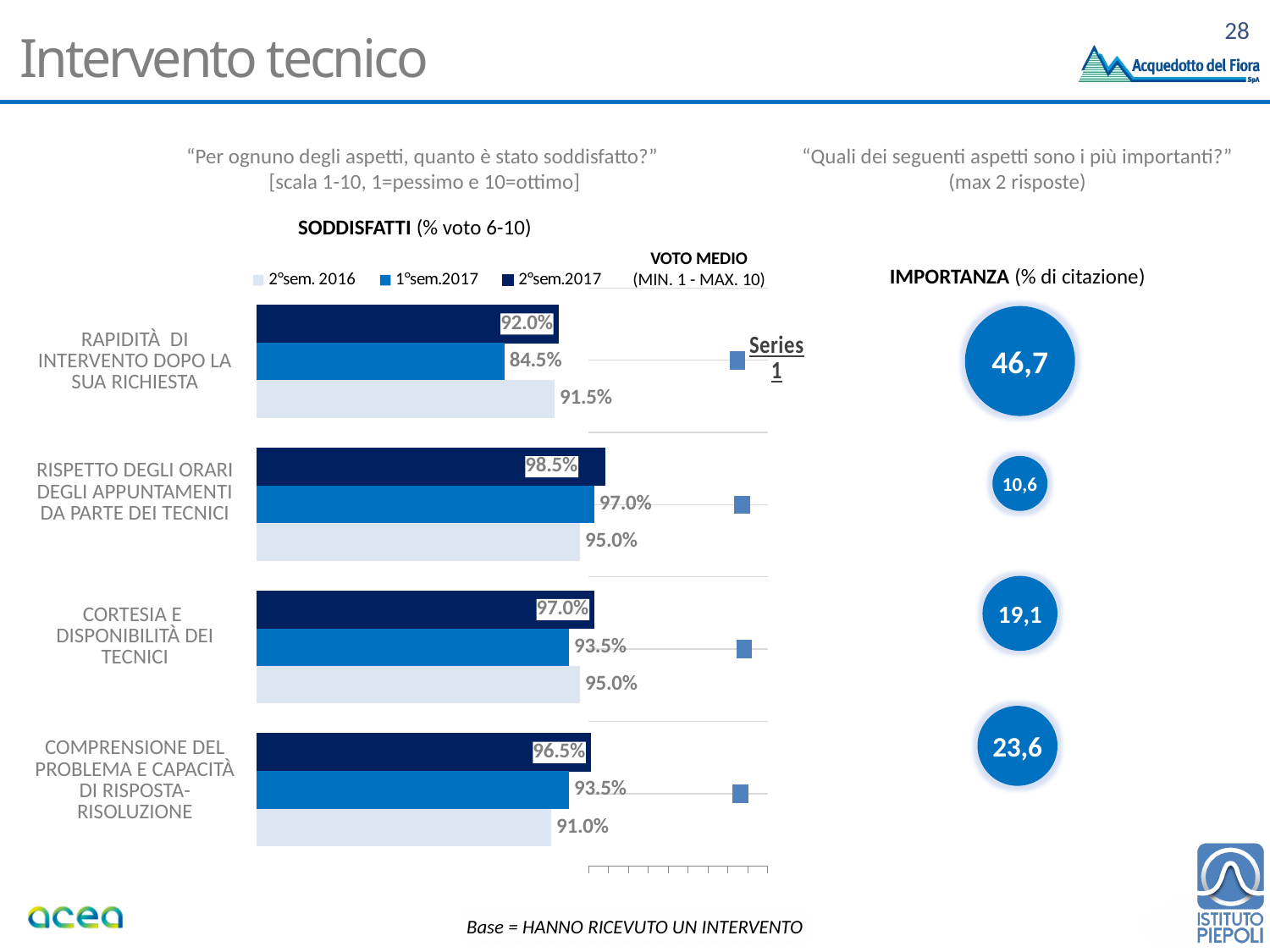
In the SODDISFATTI chart, for CORTESIA E DISPONIBILITÀ DEI TECNICI, which is larger: the 2°sem. 2016 value or the 1°sem.2017 value? 2°sem. 2016 In the IMPORTANZA (% di citazione) section, which aspect has the lowest value? RISPETTO DEGLI ORARI DEGLI APPUNTAMENTI DA PARTE DEI TECNICI How many series does the legend of the SODDISFATTI chart list? 3 In the SODDISFATTI chart, what is the 2°sem. 2016 value for COMPRENSIONE DEL PROBLEMA E CAPACITÀ DI RISPOSTA-RISOLUZIONE? 91.0% In the SODDISFATTI chart, what is the 1°sem.2017 value for RISPETTO DEGLI ORARI DEGLI APPUNTAMENTI DA PARTE DEI TECNICI? 97.0% How many categories are shown in the SODDISFATTI chart? 4 In the SODDISFATTI chart, what is the difference between the 2°sem.2017 and 1°sem.2017 values for RAPIDITÀ DI INTERVENTO DOPO LA SUA RICHIESTA? 7.5% What kind of chart is the SODDISFATTI chart? Bar chart In the IMPORTANZA (% di citazione) section, what is the value for RAPIDITÀ DI INTERVENTO DOPO LA SUA RICHIESTA? 46,7 In the SODDISFATTI chart, what is the 2°sem.2017 value for RAPIDITÀ DI INTERVENTO DOPO LA SUA RICHIESTA? 92.0% In the SODDISFATTI chart, which category has the highest 2°sem.2017 value? RISPETTO DEGLI ORARI DEGLI APPUNTAMENTI DA PARTE DEI TECNICI In the SODDISFATTI chart, which category has the lowest 1°sem.2017 value? RAPIDITÀ DI INTERVENTO DOPO LA SUA RICHIESTA